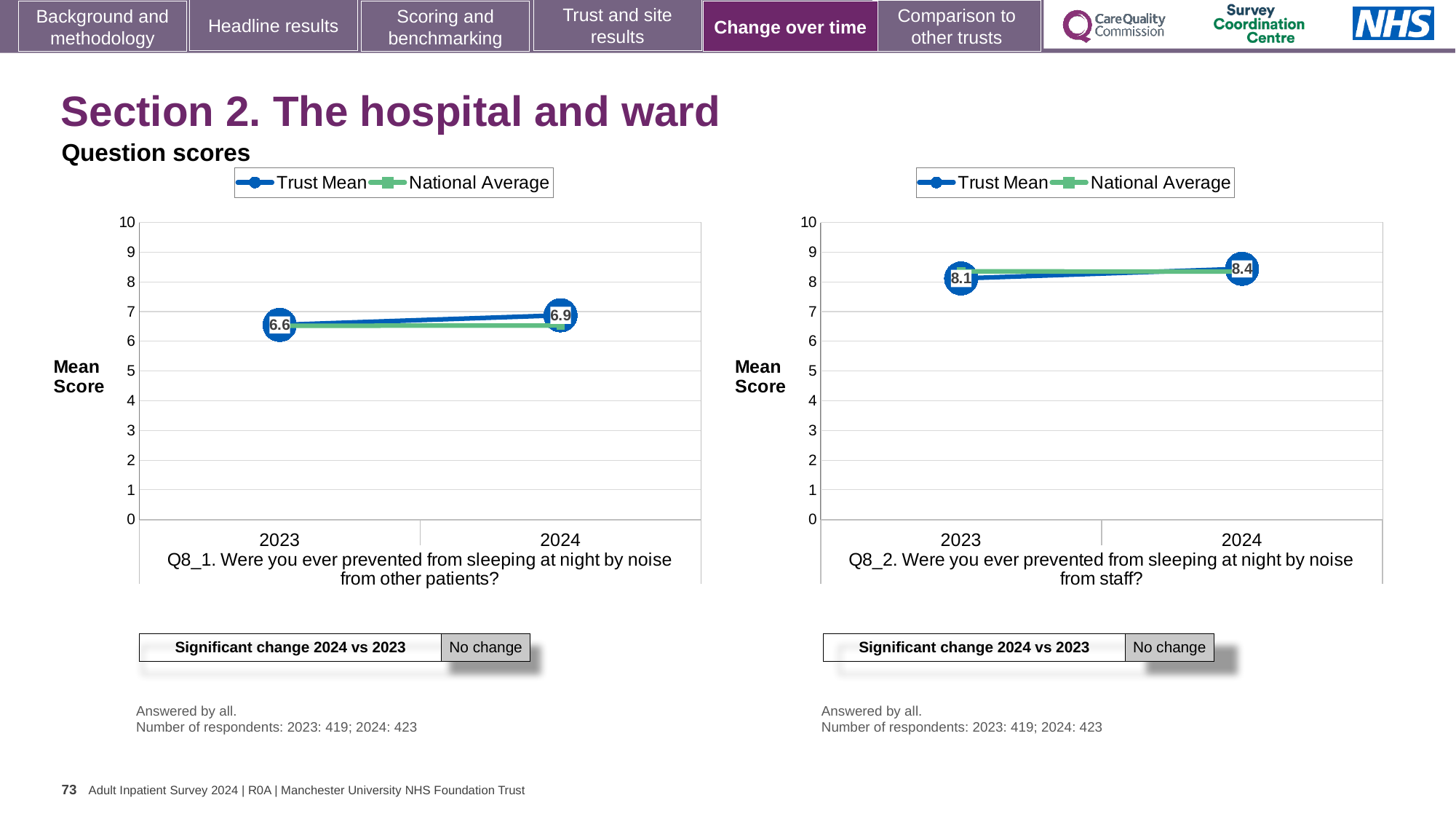
What is the y-axis label on the Q8_2 chart (right)? Mean Score In the Q8_2 chart (right), does the Trust Mean rise or fall from 2023 to 2024? rise In the Q8_1 chart (left), what is the Trust Mean score for 2023? 6.6 In the Q8_1 chart (left), is the National Average for 2024 greater or less than 7? less How many series does the legend of the Q8_2 chart (right) list? 2 In the Q8_2 chart (right), what is the Trust Mean score for 2023? 8.1 In the Q8_1 chart (left), what is the Trust Mean score for 2024? 6.9 In the Q8_2 chart (right), what is the Trust Mean score for 2024? 8.4 How many years are plotted on the x axis of the Q8_1 chart (left)? 2 In the Q8_2 chart (right), which is higher in 2023, the Trust Mean or the National Average? National Average In the Q8_1 chart (left), by how much did the Trust Mean change from 2023 to 2024? 0.3 What type of chart is the Q8_1 chart on the left? line chart